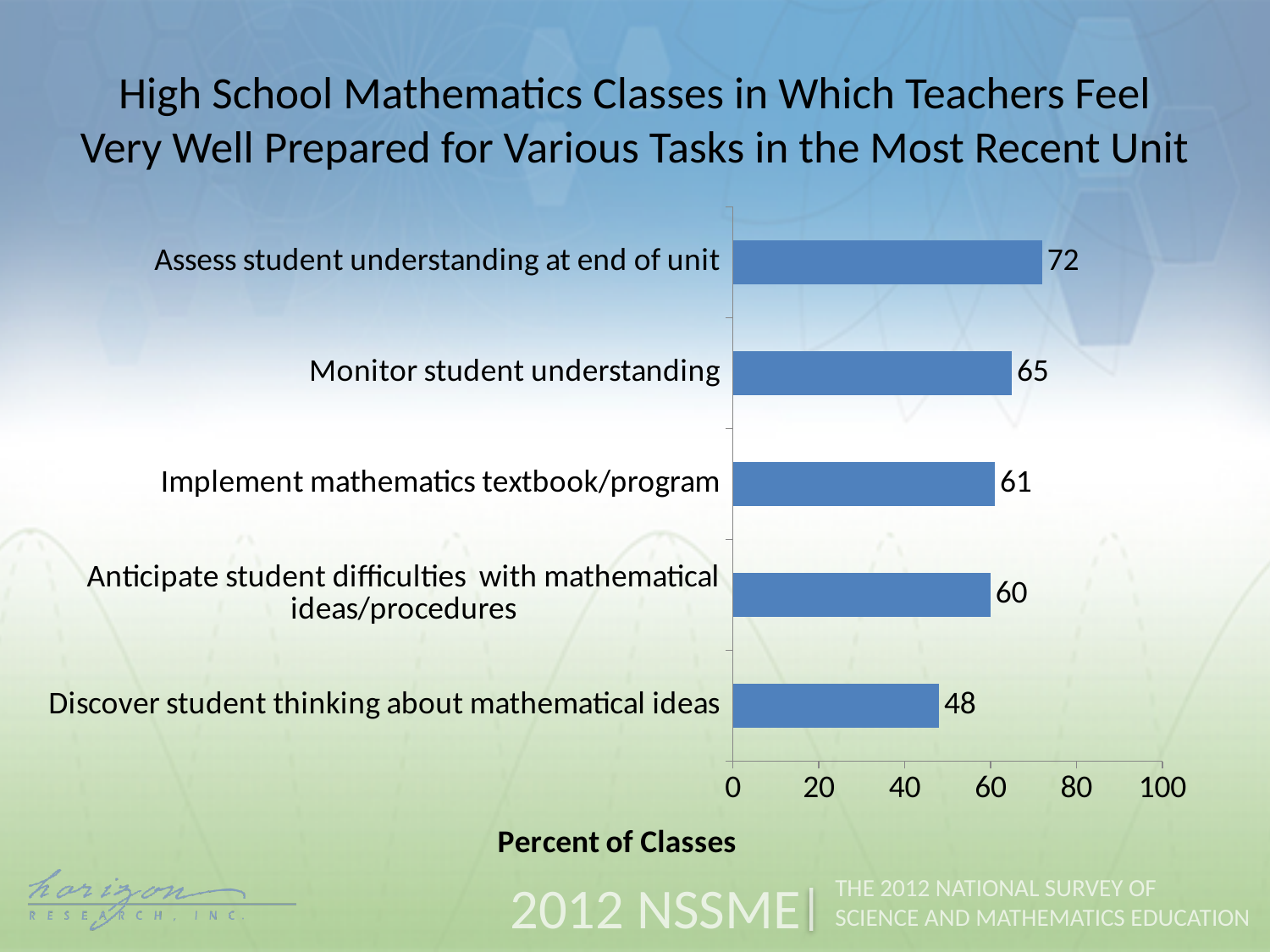
What is the label of the horizontal axis? Percent of Classes What is the difference between the values for "Assess student understanding at end of unit" and "Discover student thinking about mathematical ideas"? 24 What is the value for "Implement mathematics textbook/program"? 61 What is the value for "Monitor student understanding"? 65 Which task has the lowest percent of classes? Discover student thinking about mathematical ideas Is the value for "Discover student thinking about mathematical ideas" greater or less than 60? less Which task has the highest percent of classes? Assess student understanding at end of unit Which is larger: the value for "Monitor student understanding" or the value for "Anticipate student difficulties with mathematical ideas/procedures"? Monitor student understanding What kind of chart is shown on the slide? Bar chart What is the value for "Discover student thinking about mathematical ideas"? 48 How many tasks (categories) are shown in the chart? 5 What is the value for "Assess student understanding at end of unit"? 72